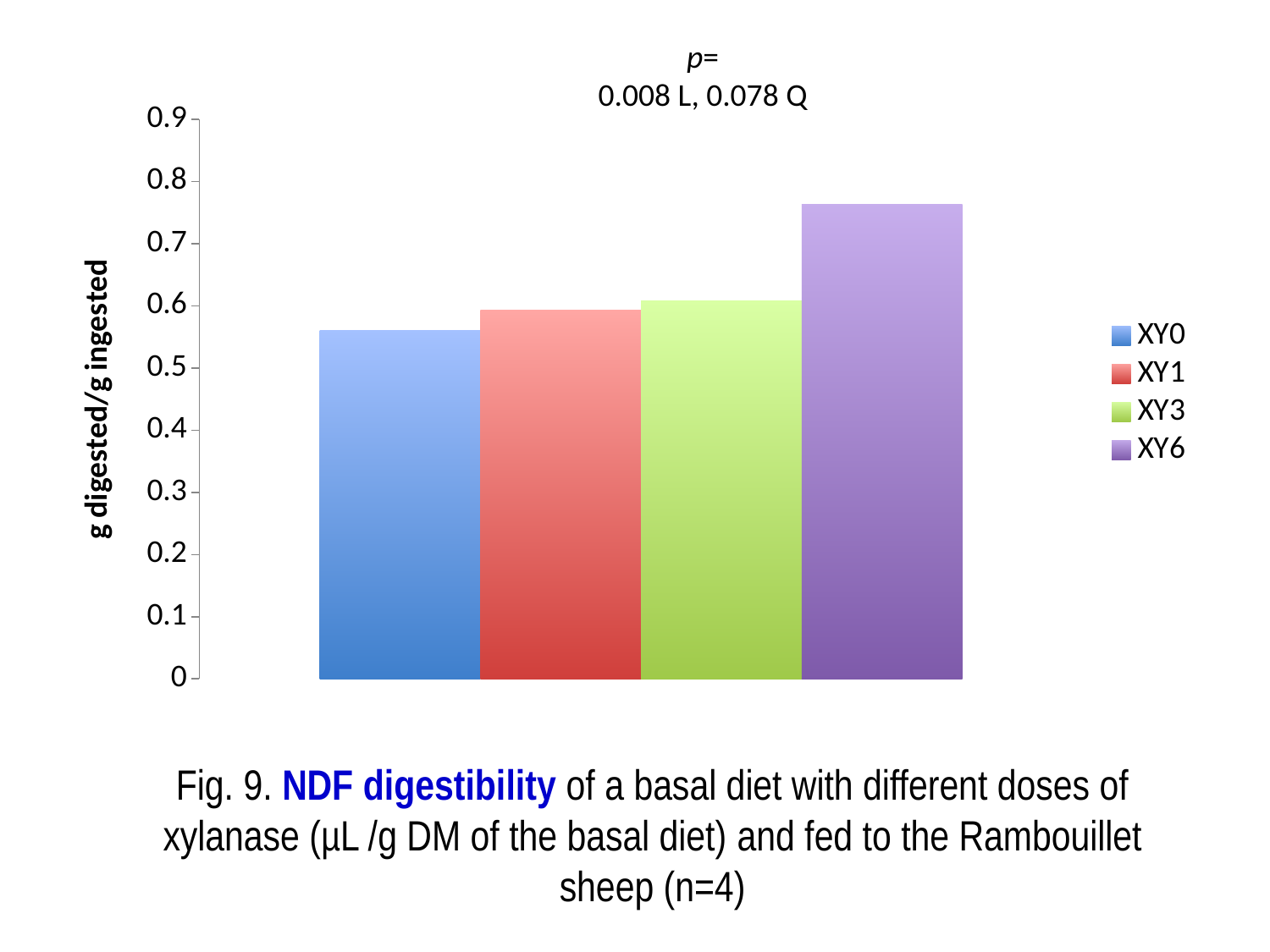
Which treatment has the highest NDF digestibility? XY6 Which has the larger value, XY3 or XY6? XY6 How many bars are plotted in the chart? 4 Is the value for XY6 greater or less than 0.7? greater Is the value for XY6 greater or less than 0.8? less Which treatment has the lowest NDF digestibility? XY0 What kind of chart is shown on the slide? bar chart Is the value for XY0 greater or less than 0.6? less Do the values rise or fall from XY0 to XY6? rise What is the label on the vertical axis of the chart? g digested/g ingested How many entries does the legend list? 4 Which has the larger value, XY0 or XY1? XY1